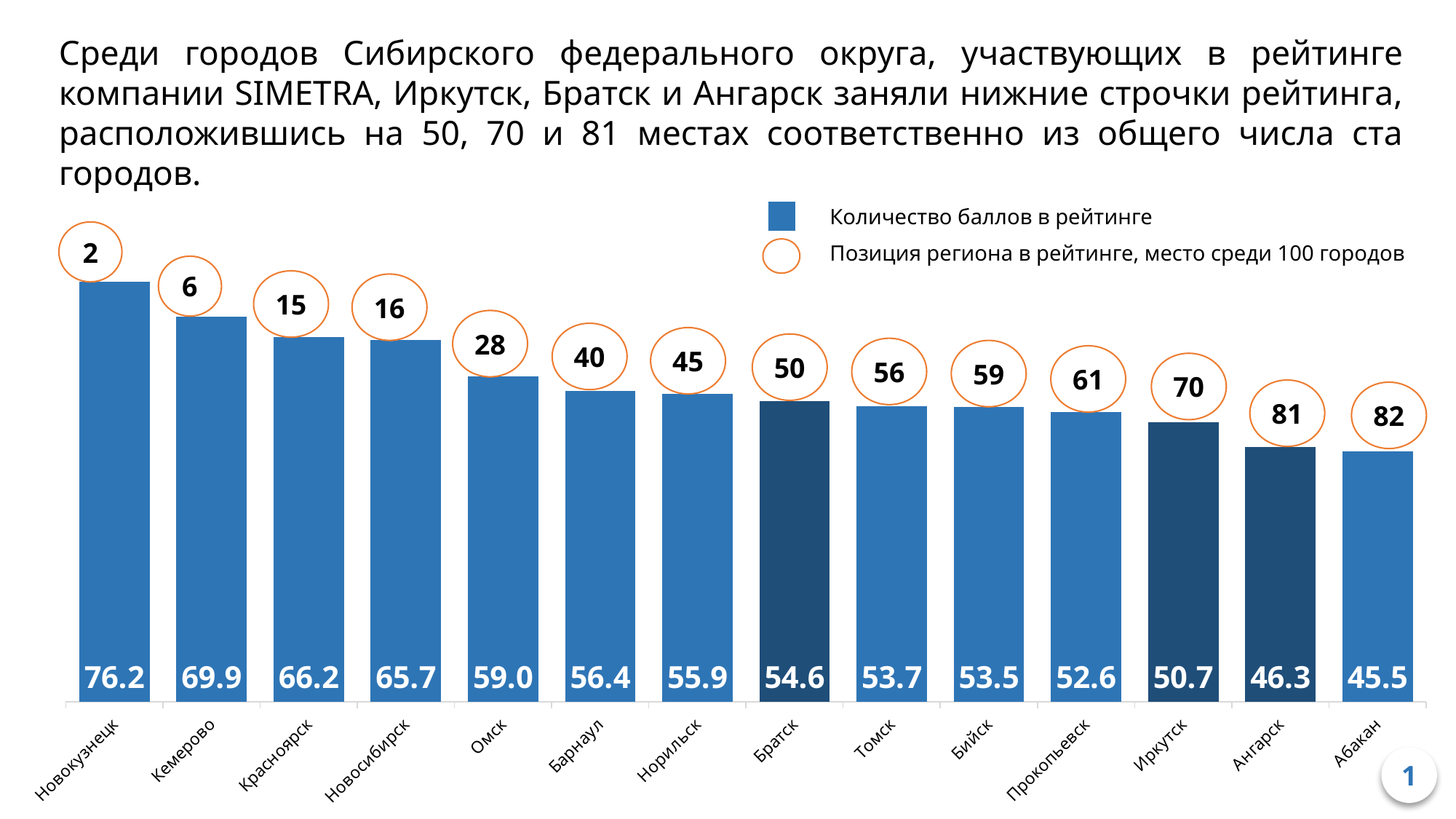
Which city has the higher rating score, Омск or Томск? Омск What kind of chart is shown on the slide? Bar chart What is the rating score (Количество баллов в рейтинге) for Новокузнецк? 76.2 Do the rating scores rise or fall from left to right along the x axis? Fall What is the rating score for Иркутск? 50.7 What rating position is shown for Ангарск? 81 How many entries does the legend list? 2 Which city has the highest rating score? Новокузнецк How many cities are shown in the chart? 14 Which city has the lowest rating score? Абакан What is the difference between the rating scores of Новокузнецк and Абакан? 30.7 What rating position (Позиция региона в рейтинге) is shown for Братск? 50